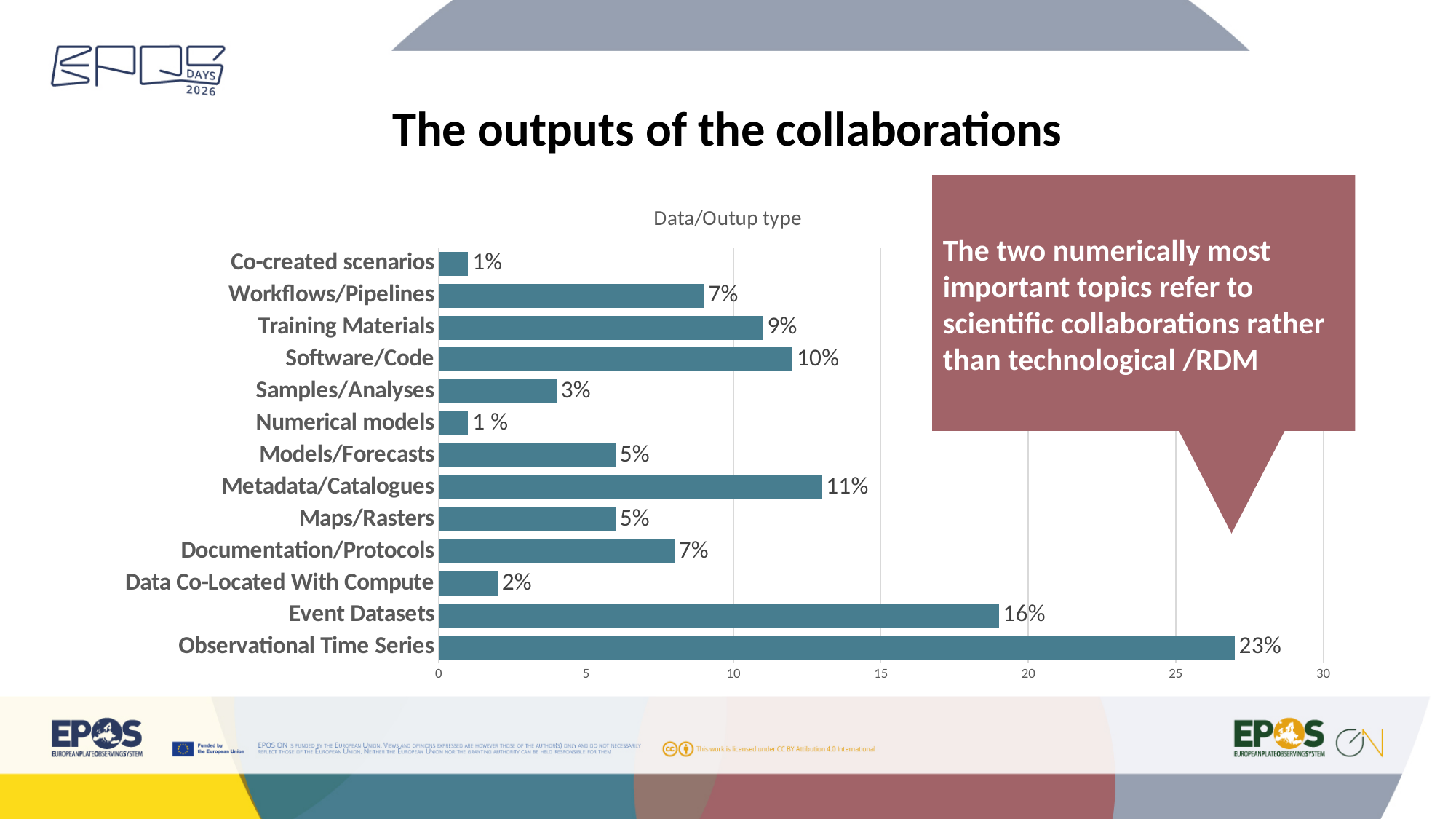
What is the data label for Metadata/Catalogues? 11% What is the title of the chart? Data/Outup type How many categories are plotted in the chart? 13 What is the difference in percentage points between Observational Time Series and Event Datasets? 7 What kind of chart is shown on the slide? bar chart Which category has the highest value? Observational Time Series Which is larger, Training Materials or Samples/Analyses? Training Materials What is the data label for Observational Time Series? 23% What is the data label for Event Datasets? 16% What is the data label for Data Co-Located With Compute? 2% Is the bar for Observational Time Series greater or less than 25 on the axis? greater What is the data label for Software/Code? 10%